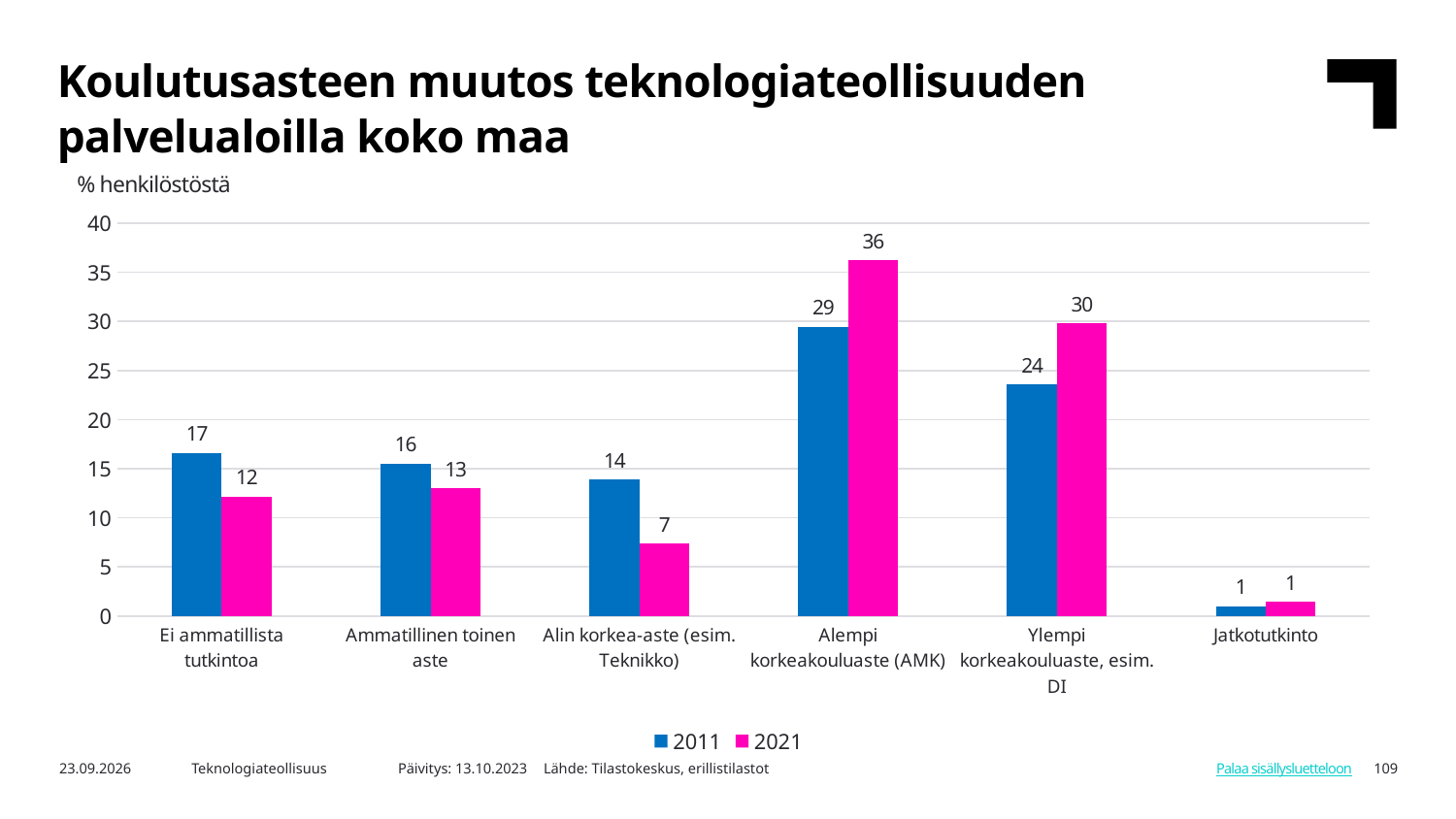
How many series does the legend list? 2 Which category has the lowest 2011 value? Jatkotutkinto Which category has the highest 2021 value? Alempi korkeakouluaste (AMK) What kind of chart is shown on the slide? Bar chart What is the difference between the 2011 and 2021 values for Ei ammatillista tutkintoa? 5 What is the 2021 value for Alempi korkeakouluaste (AMK)? 36 How many categories are shown on the x axis? 6 Which is larger for Ylempi korkeakouluaste, esim. DI: the 2011 value or the 2021 value? 2021 What unit is indicated above the chart? % henkilöstöstä What is the 2021 value for Alin korkea-aste (esim. Teknikko)? 7 What is the difference between the 2021 and 2011 values for Alempi korkeakouluaste (AMK)? 7 What is the 2011 value for Ei ammatillista tutkintoa? 17